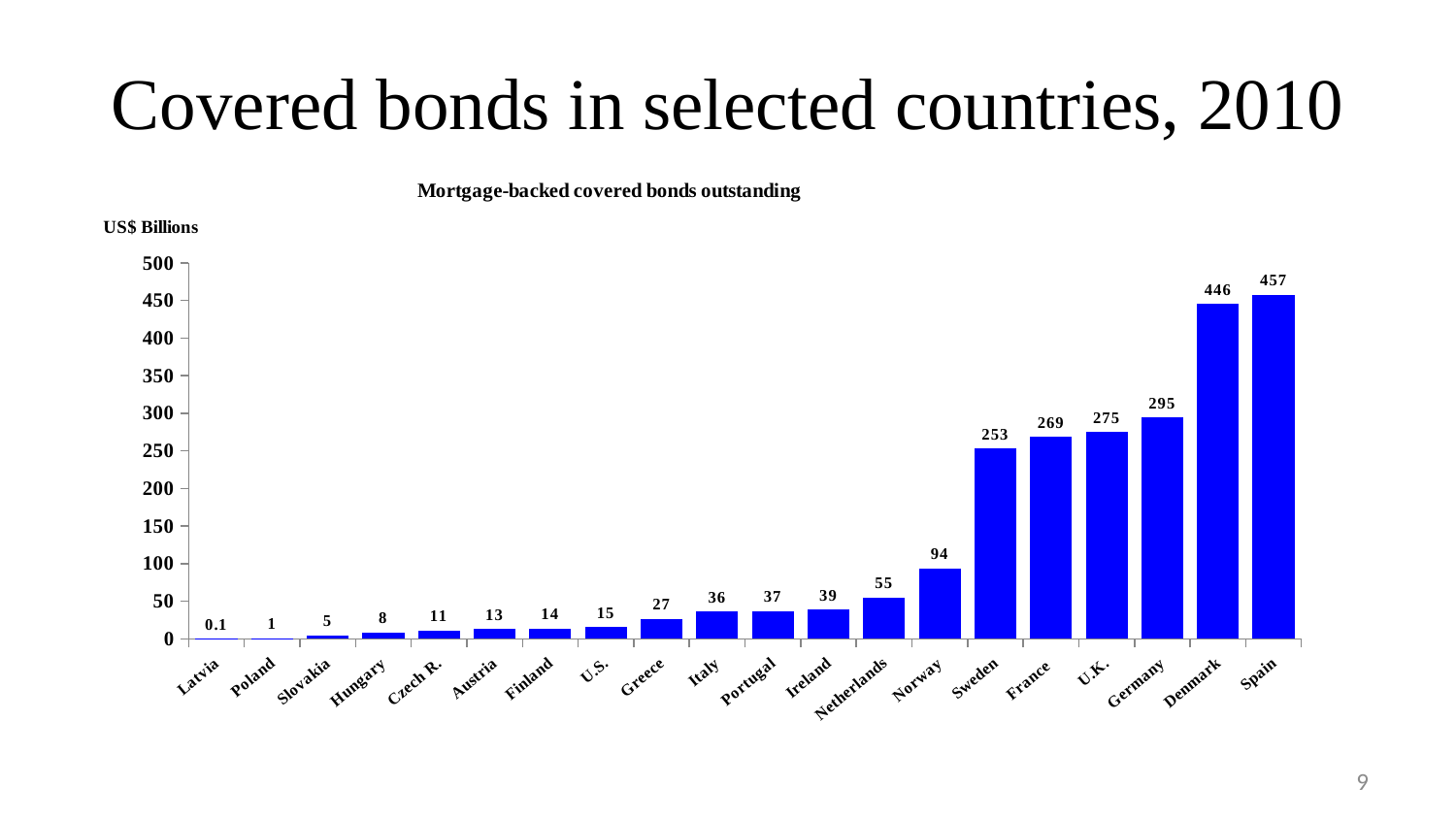
What is the value for Norway? 94 Which country has the lowest value? Latvia What kind of chart is shown? Bar chart Is the value for Germany greater or less than 250? greater What is the value for Germany? 295 What is the difference between the values for Spain and Denmark? 11 How many countries are shown on the chart? 20 What is the difference between the values for Sweden and Norway? 159 What unit is shown on the y axis label? US$ Billions Which country has the highest value? Spain Which is larger, the value for U.K. or the value for France? U.K. What is the value for Spain? 457